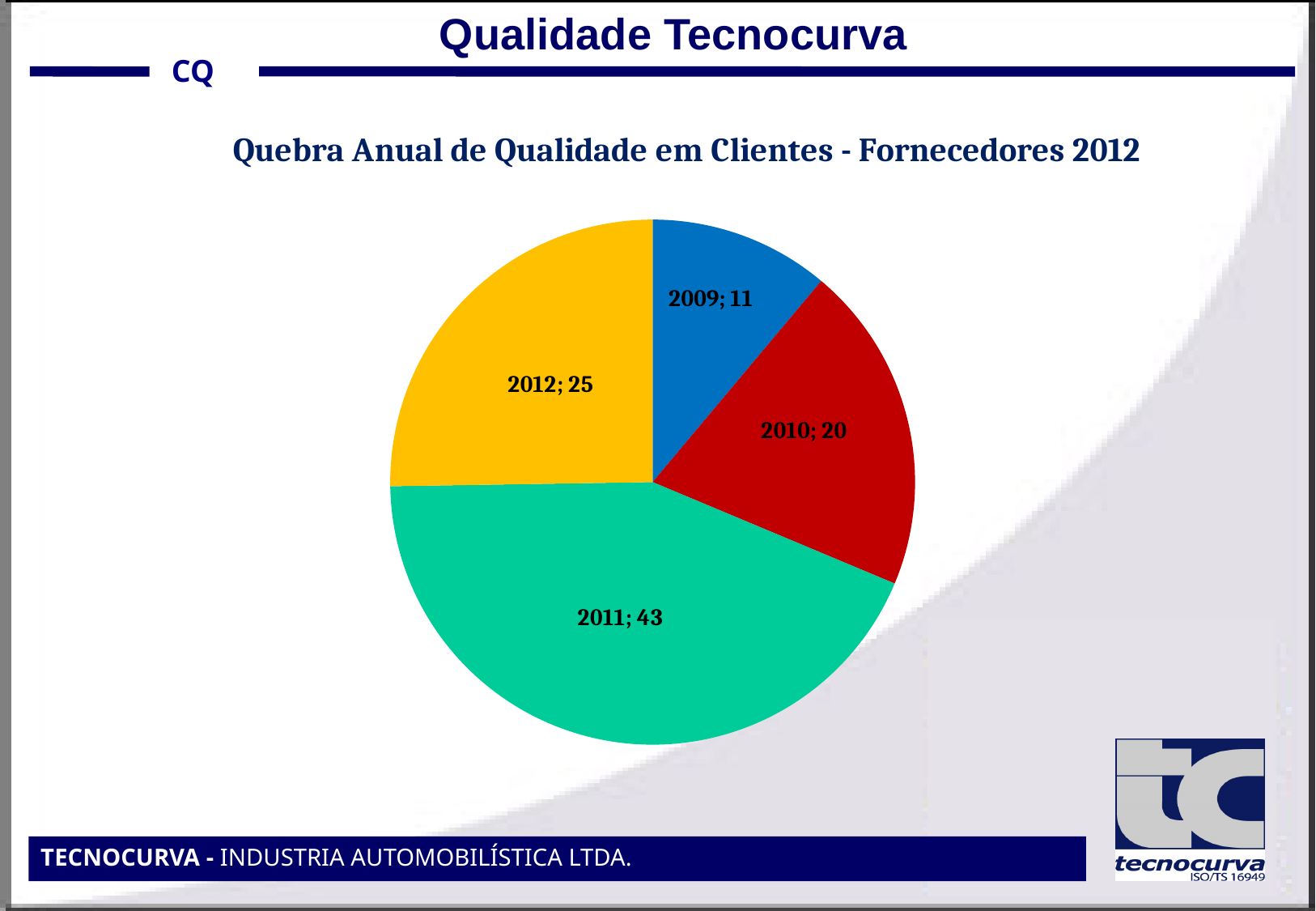
What is the title of the chart? Quebra Anual de Qualidade em Clientes - Fornecedores 2012 What is the total of all the slices in the pie chart? 99 How many slices does the pie chart have? 4 What is the value for 2009? 11 What is the value for 2012? 25 What is the value for 2011? 43 What kind of chart is shown on the slide? pie chart Which year has the largest slice? 2011 What is the difference between the values for 2011 and 2012? 18 Which year has the smallest slice? 2009 Which is larger, the value for 2010 or the value for 2012? 2012 What is the value for 2010? 20